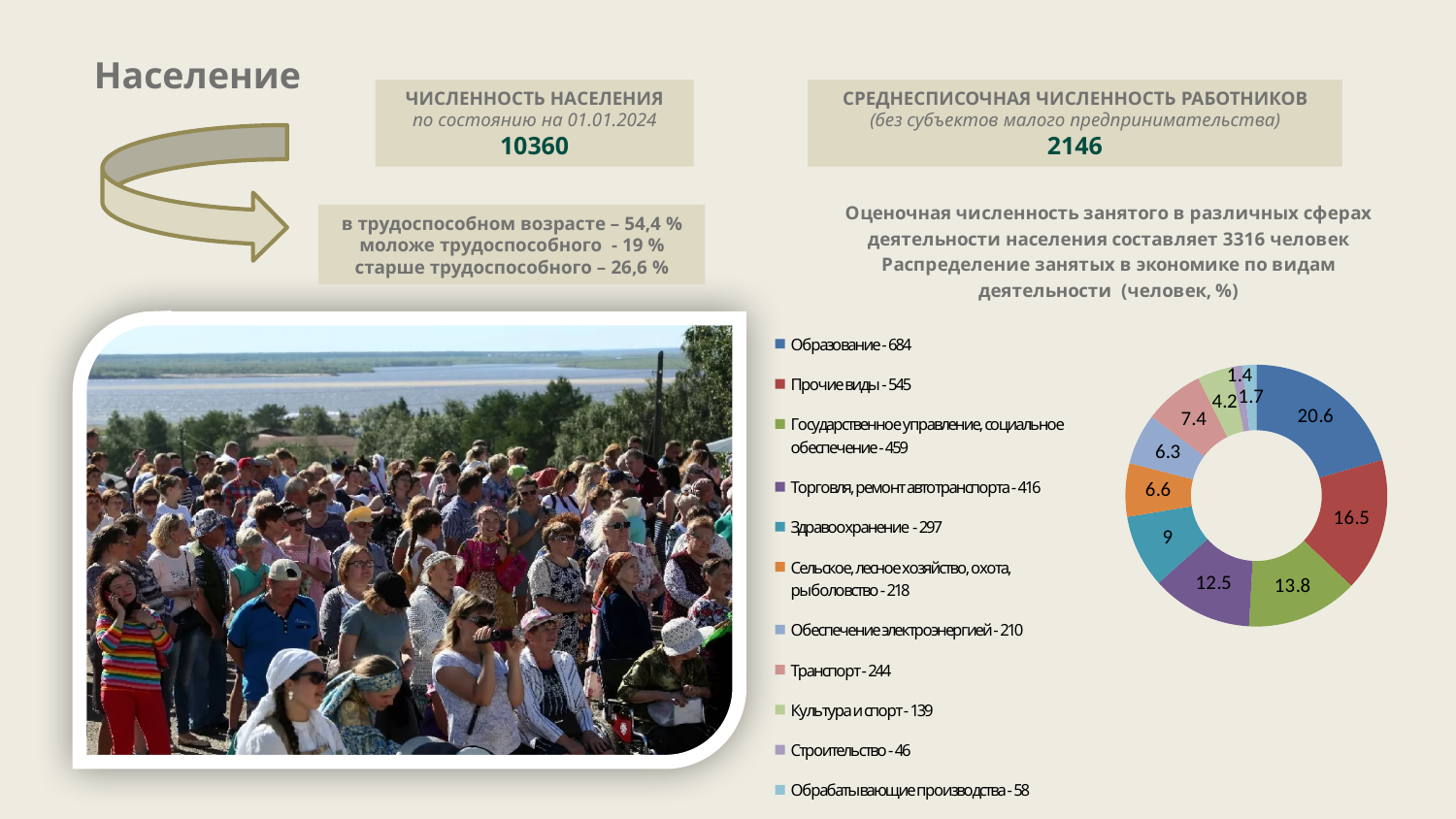
According to the legend, how many people are employed in Культура и спорт? 139 What percentage is shown for the largest slice (Образование)? 20.6 Which slice is larger: Сельское, лесное хозяйство, охота, рыболовство or Обеспечение электроэнергией? Сельское, лесное хозяйство, охота, рыболовство Which category has the smallest share in the chart? Строительство How many categories does the legend of the chart list? 11 What percentage is shown for the Транспорт slice? 7.4 What percentage is shown for the Здравоохранение slice? 9 Which category has the largest share in the chart? Образование What is the difference in percentage points between the Образование slice (20.6) and the Прочие виды slice (16.5)? 4.1 According to the legend, how many people are employed in Торговля, ремонт автотранспорта? 416 What is the title text above the chart describing what it shows? Распределение занятых в экономике по видам деятельности (человек, %) What kind of chart is shown on the slide? Pie (doughnut) chart